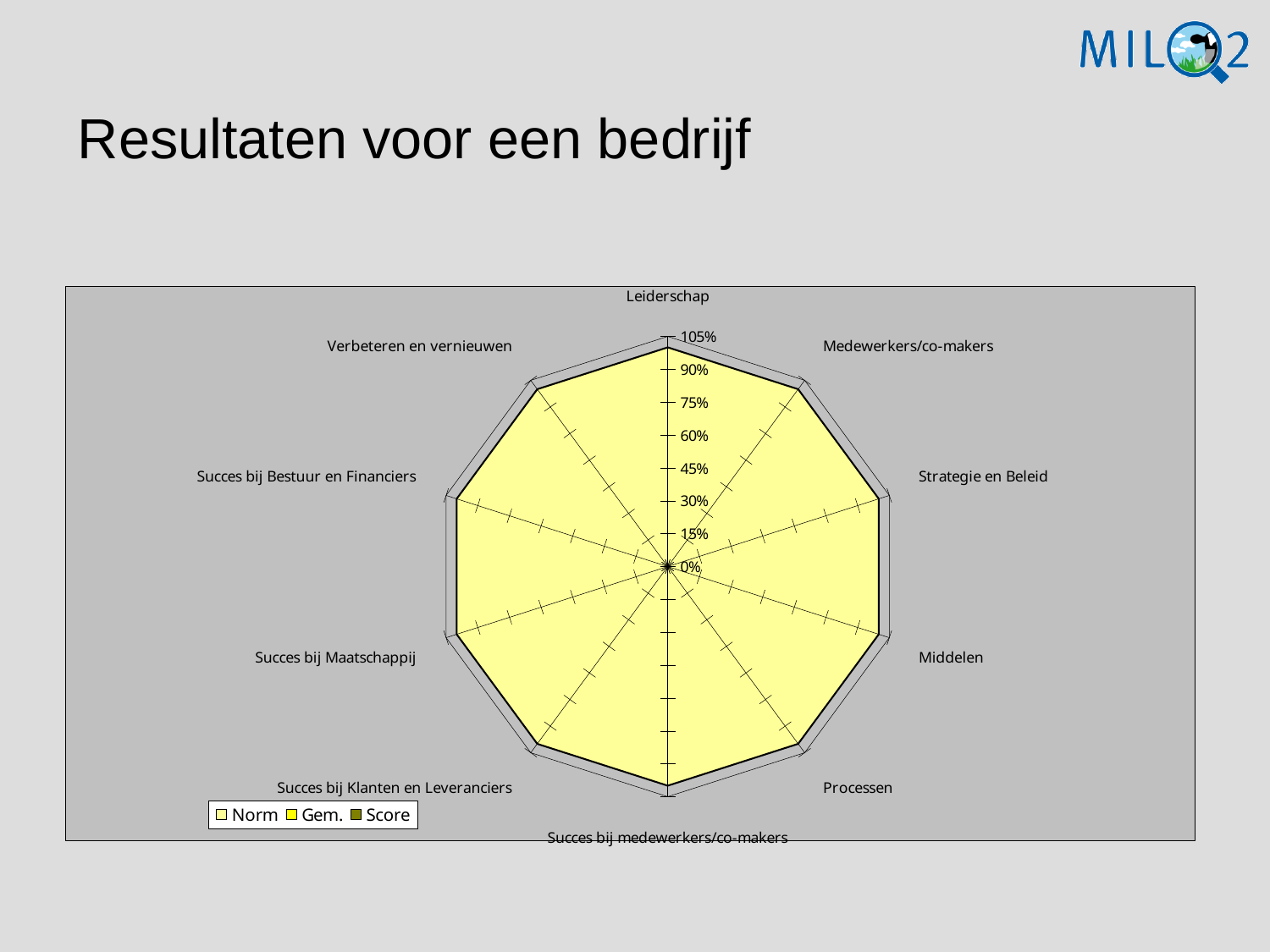
How many series does the legend of the radar chart list? 3 Are the plotted values for Leiderschap greater or less than 60%? greater What are the series names listed in the legend of the radar chart? Norm, Gem., Score Are the plotted values for Succes bij Maatschappij greater or less than 30%? greater Are the plotted values for Strategie en Beleid greater or less than 60%? greater What is the title of the slide containing the radar chart? Resultaten voor een bedrijf What kind of chart is shown on the slide? Radar chart How many categories (axes) does the radar chart have? 10